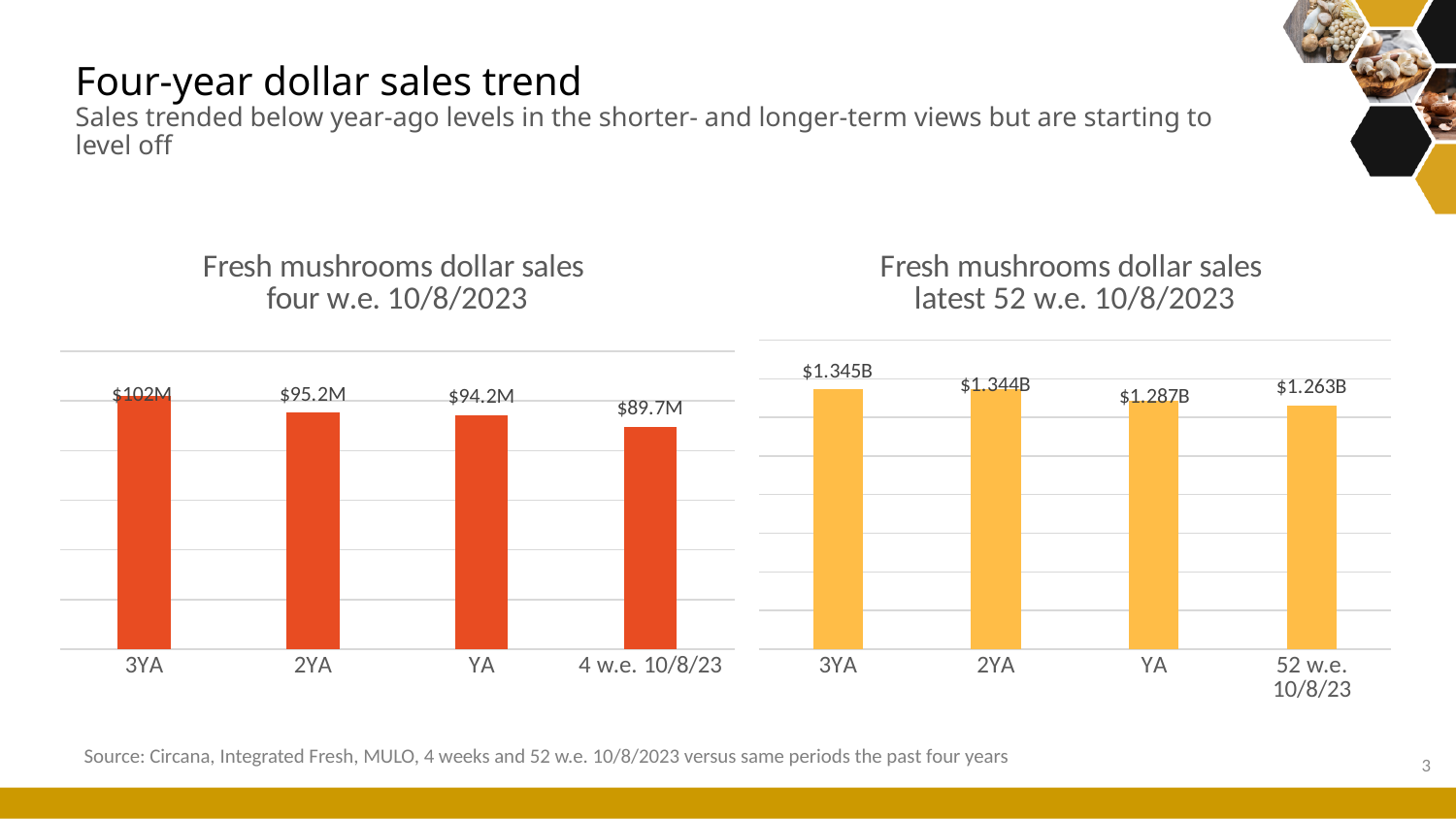
In the 'Fresh mushrooms dollar sales latest 52 w.e. 10/8/2023' chart, what is the value for 52 w.e. 10/8/23? $1.263B In the 'Fresh mushrooms dollar sales latest 52 w.e. 10/8/2023' chart, what is the value for YA? $1.287B In the 'Fresh mushrooms dollar sales four w.e. 10/8/2023' chart, which is larger, the value for 2YA or the value for 4 w.e. 10/8/23? 2YA What kind of chart is the 'Fresh mushrooms dollar sales four w.e. 10/8/2023' chart? Bar chart In the 'Fresh mushrooms dollar sales latest 52 w.e. 10/8/2023' chart, what is the difference between the YA value and the 52 w.e. 10/8/23 value? $0.024B In the 'Fresh mushrooms dollar sales latest 52 w.e. 10/8/2023' chart, which category has the lowest value? 52 w.e. 10/8/23 In the 'Fresh mushrooms dollar sales four w.e. 10/8/2023' chart, what is the value for 4 w.e. 10/8/23? $89.7M How many categories are shown in the 'Fresh mushrooms dollar sales latest 52 w.e. 10/8/2023' chart? 4 In the 'Fresh mushrooms dollar sales four w.e. 10/8/2023' chart, which category has the highest value? 3YA In the 'Fresh mushrooms dollar sales four w.e. 10/8/2023' chart, do the values rise or fall from 3YA to 4 w.e. 10/8/23? Fall In the 'Fresh mushrooms dollar sales four w.e. 10/8/2023' chart, what is the difference between the 3YA value and the 4 w.e. 10/8/23 value? $12.3M In the 'Fresh mushrooms dollar sales four w.e. 10/8/2023' chart, what is the value for 3YA? $102M